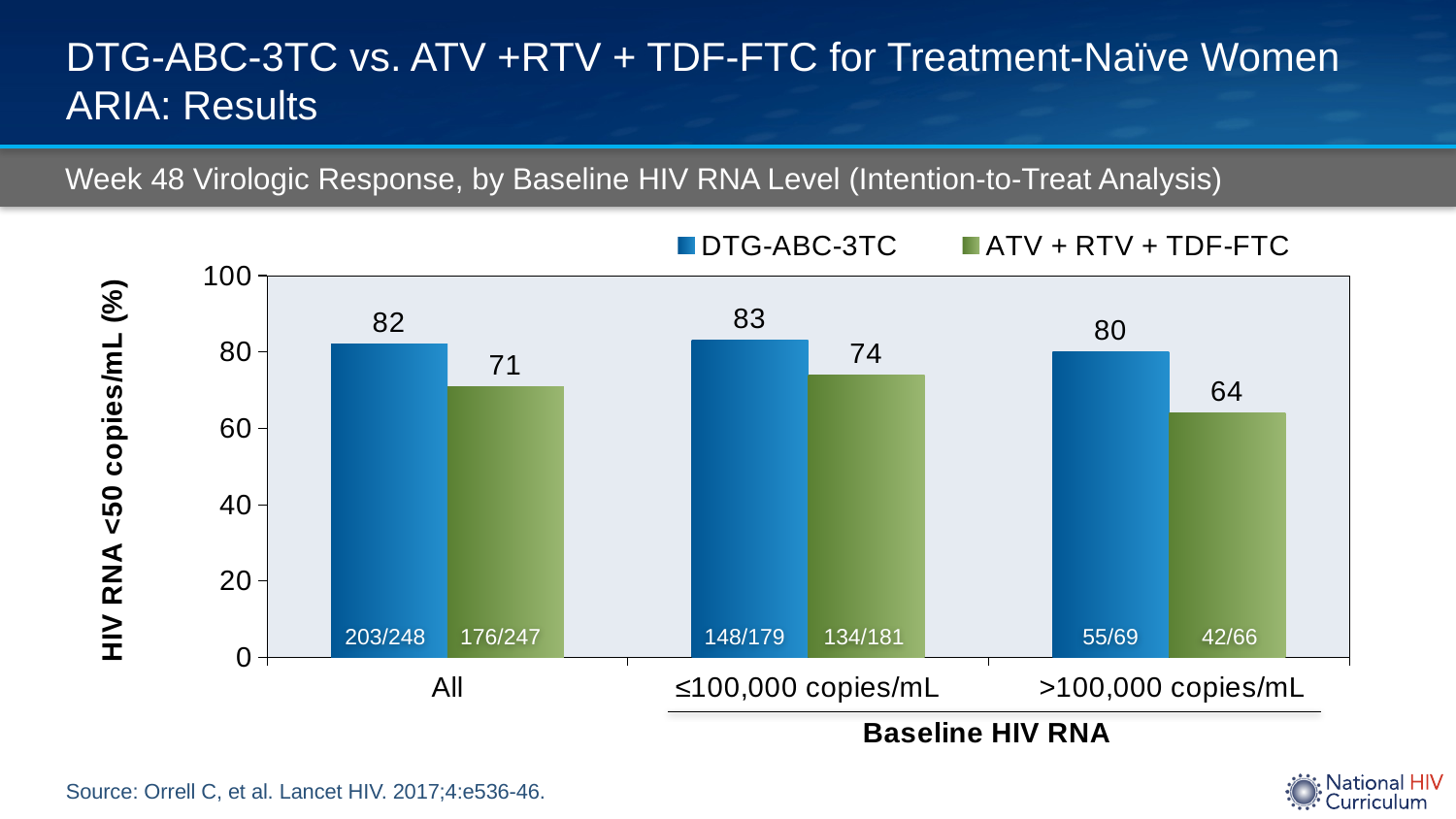
How many categories are shown on the x axis? 3 What is the value for DTG-ABC-3TC in the All category? 82 What is the value for ATV + RTV + TDF-FTC in the >100,000 copies/mL category? 64 In the ≤100,000 copies/mL category, which series has the larger value? DTG-ABC-3TC Which category has the lowest value for ATV + RTV + TDF-FTC? >100,000 copies/mL How many series does the legend list? 2 What is the difference between DTG-ABC-3TC and ATV + RTV + TDF-FTC in the All category? 11 What kind of chart is shown on the slide? Bar chart What is the label of the y axis? HIV RNA <50 copies/mL (%) What is the difference between DTG-ABC-3TC and ATV + RTV + TDF-FTC in the >100,000 copies/mL category? 16 Which category has the highest value for DTG-ABC-3TC? ≤100,000 copies/mL What is the value for ATV + RTV + TDF-FTC in the ≤100,000 copies/mL category? 74